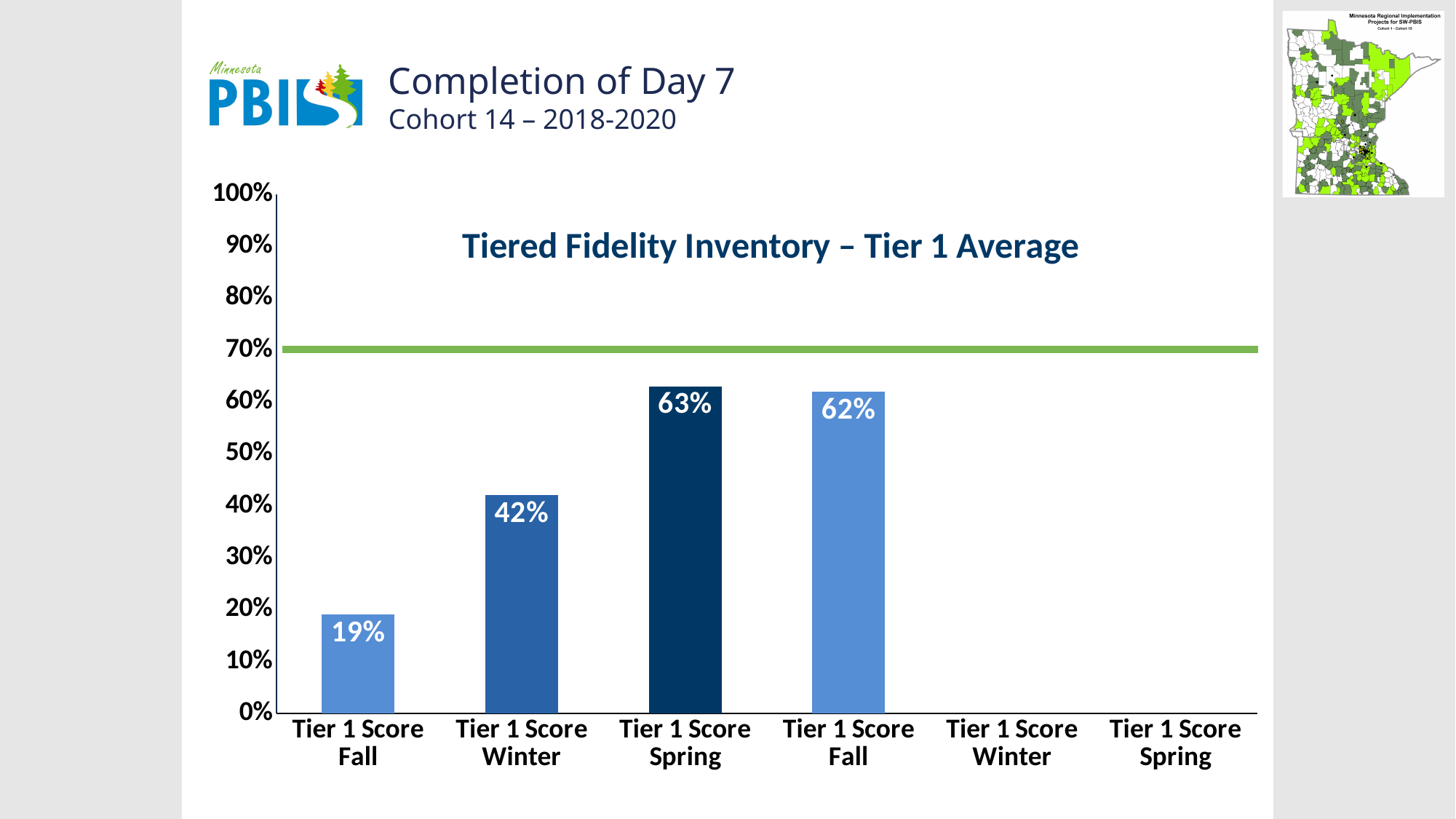
What is the value of the fourth bar, the second Tier 1 Score Fall? 62% Which bar has the lowest value? Tier 1 Score Fall (first bar), 19% What type of chart is shown on the slide? bar chart Which bar has the highest value? Tier 1 Score Spring (third bar), 63% What is the value of the Tier 1 Score Winter bar (the second bar)? 42% What is the value of the Tier 1 Score Spring bar (the third bar)? 63% How many category labels are shown on the x axis? 6 What is the value of the first bar, Tier 1 Score Fall? 19% Which is larger, the Tier 1 Score Winter bar (second bar) or the first Tier 1 Score Fall bar? Tier 1 Score Winter At what value is the horizontal green line drawn? 70% What is the difference between the Tier 1 Score Spring bar (63%) and the first Tier 1 Score Fall bar (19%)? 44% What is the title of the chart? Tiered Fidelity Inventory – Tier 1 Average